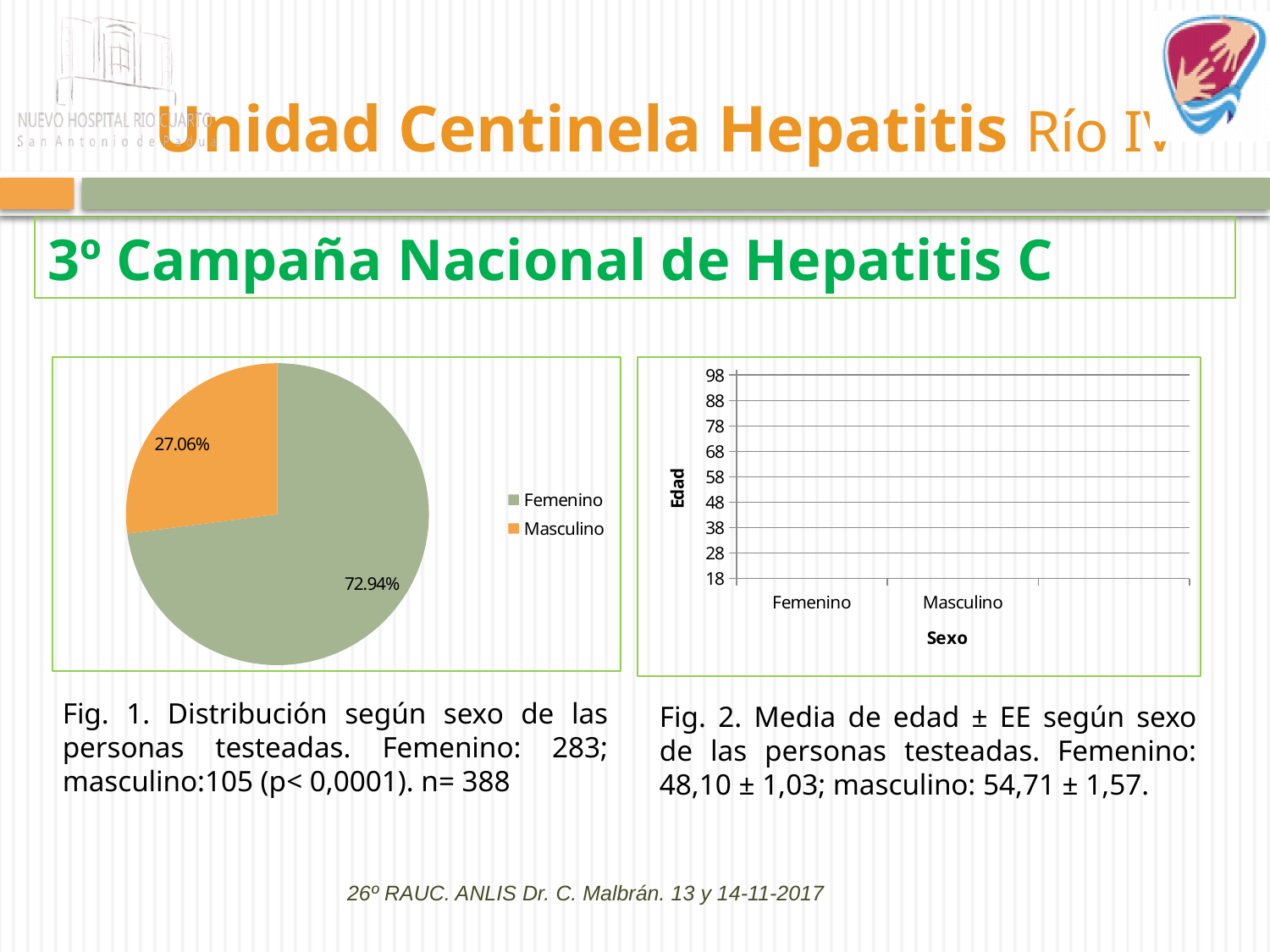
In the chart on the right, what is the title of the vertical axis? Edad In the pie chart on the left, which category has the smallest slice? Masculino In the pie chart on the left, what percentage is shown for Masculino? 27.06% In the pie chart on the left, what is the difference in percentage points between the Femenino and Masculino slices? 45.88% How many entries does the legend of the pie chart on the left list? 2 In the pie chart on the left, which slice is larger, Femenino or Masculino? Femenino In the pie chart on the left, what percentage is shown for Femenino? 72.94% In the pie chart on the left, what share of the pie does the Masculino slice represent? 27.06% How many slices does the pie chart on the left have? 2 In the pie chart on the left, what colour is the Masculino slice? Orange What kind of chart is the chart on the left of the slide? Pie chart In the pie chart on the left, which category has the largest slice? Femenino